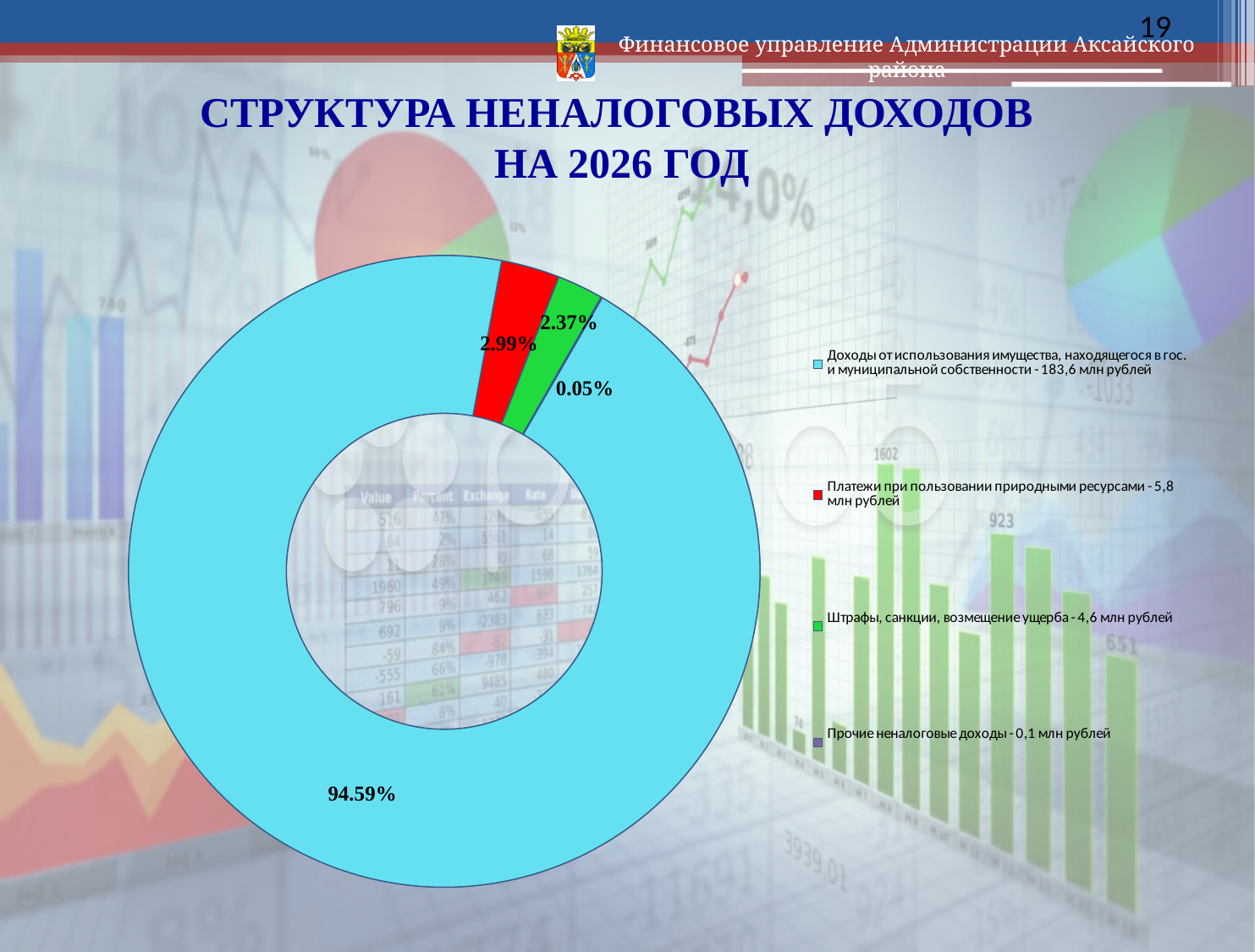
What share of the chart is 'Штрафы, санкции, возмещение ущерба'? 2.37% According to the legend, what is the amount for 'Платежи при пользовании природными ресурсами'? 5,8 млн рублей According to the legend, what is the amount for 'Штрафы, санкции, возмещение ущерба'? 4,6 млн рублей What share of the chart is 'Прочие неналоговые доходы'? 0.05% What kind of chart is shown on the slide? Doughnut (pie) chart What is the difference in percentage points between the shares of 'Платежи при пользовании природными ресурсами' and 'Штрафы, санкции, возмещение ущерба'? 0.62% What is the title of the chart on the slide? СТРУКТУРА НЕНАЛОГОВЫХ ДОХОДОВ НА 2026 ГОД Which category has the smallest share of non-tax revenues? Прочие неналоговые доходы What share of non-tax revenues is 'Доходы от использования имущества, находящегося в гос. и муниципальной собственности'? 94.59% How many categories does the legend list? 4 Which category has the largest share of non-tax revenues? Доходы от использования имущества, находящегося в гос. и муниципальной собственности